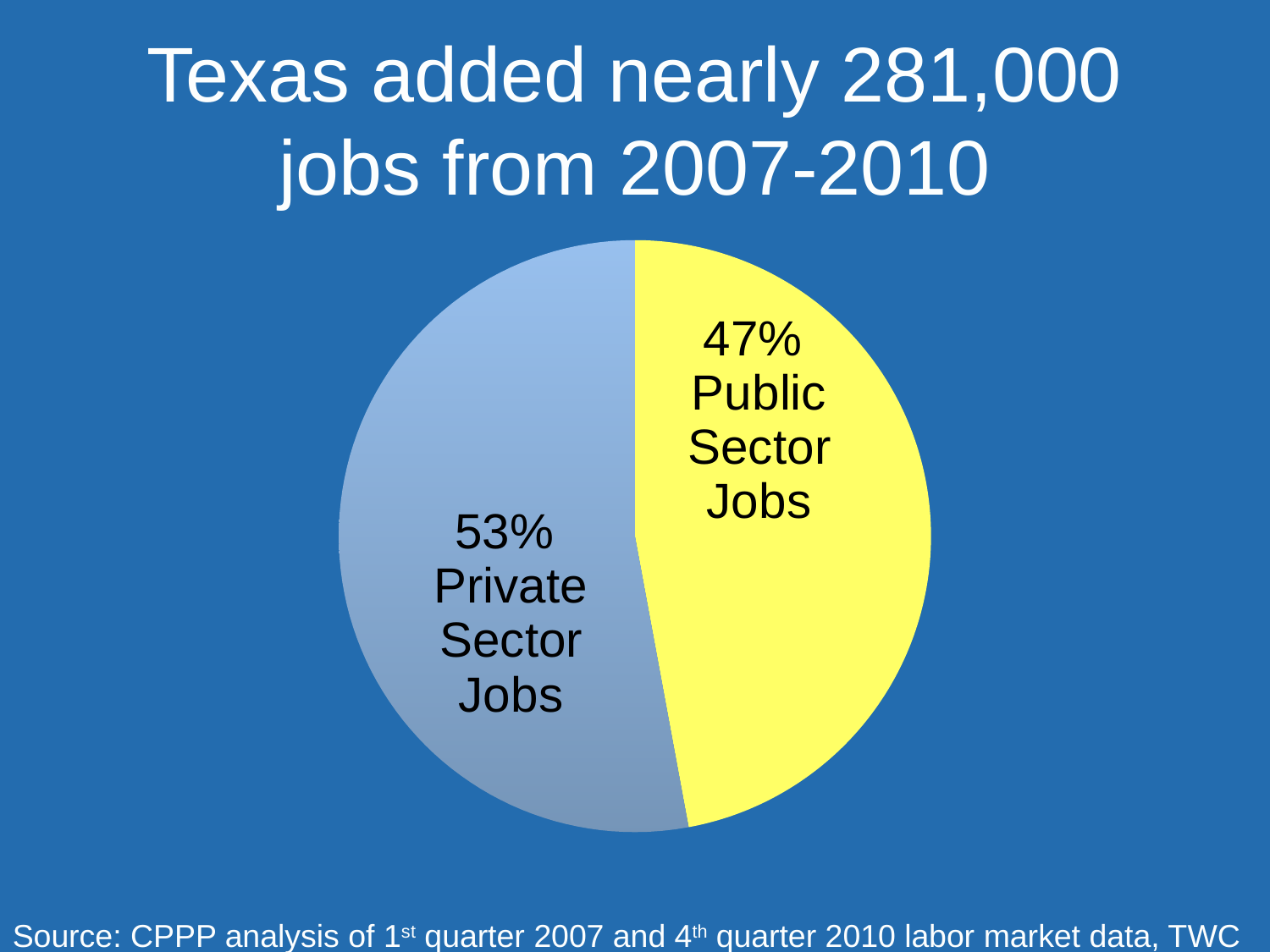
What kind of chart is shown on the slide? pie chart What share of the jobs added were Public Sector Jobs? 47% What colour is the Public Sector Jobs slice? yellow What is the title of the slide containing the pie chart? Texas added nearly 281,000 jobs from 2007-2010 Which is larger, the share of Private Sector Jobs or the share of Public Sector Jobs? Private Sector Jobs What is the difference in percentage points between the Private Sector Jobs share and the Public Sector Jobs share? 6 How many slices does the pie chart have? 2 What share of the jobs added were Private Sector Jobs? 53% Which slice of the pie is the largest? Private Sector Jobs Is the share of Public Sector Jobs greater or less than 50%? less Which slice of the pie is the smallest? Public Sector Jobs